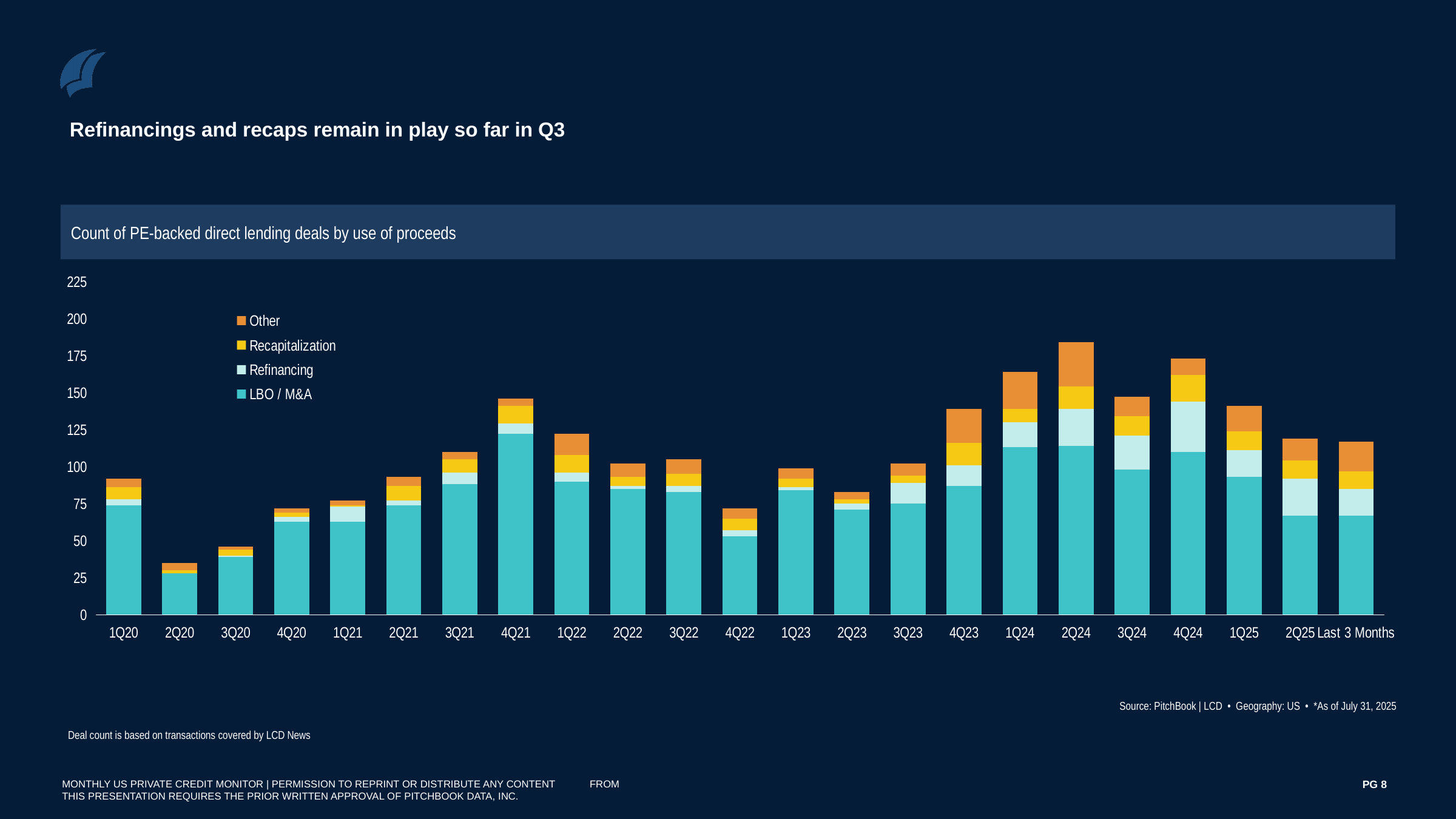
Do the total deal counts rise or fall from 2Q20 to 4Q21? rise How many quarterly/period categories are shown along the x axis? 23 Is the total deal count for 2Q24 greater or less than 175? greater What kind of chart is shown on the slide? Stacked bar chart Which period has the lowest total deal count? 2Q20 What is the title of the chart? Count of PE-backed direct lending deals by use of proceeds Is the total deal count for 2Q20 greater or less than 50? less Is the total deal count for 4Q21 greater or less than 125? greater Which period has the highest total deal count? 2Q24 How many series does the legend list? 4 Which period has a larger total deal count, 1Q24 or 2Q23? 1Q24 Which series is shown in orange in the legend? Other